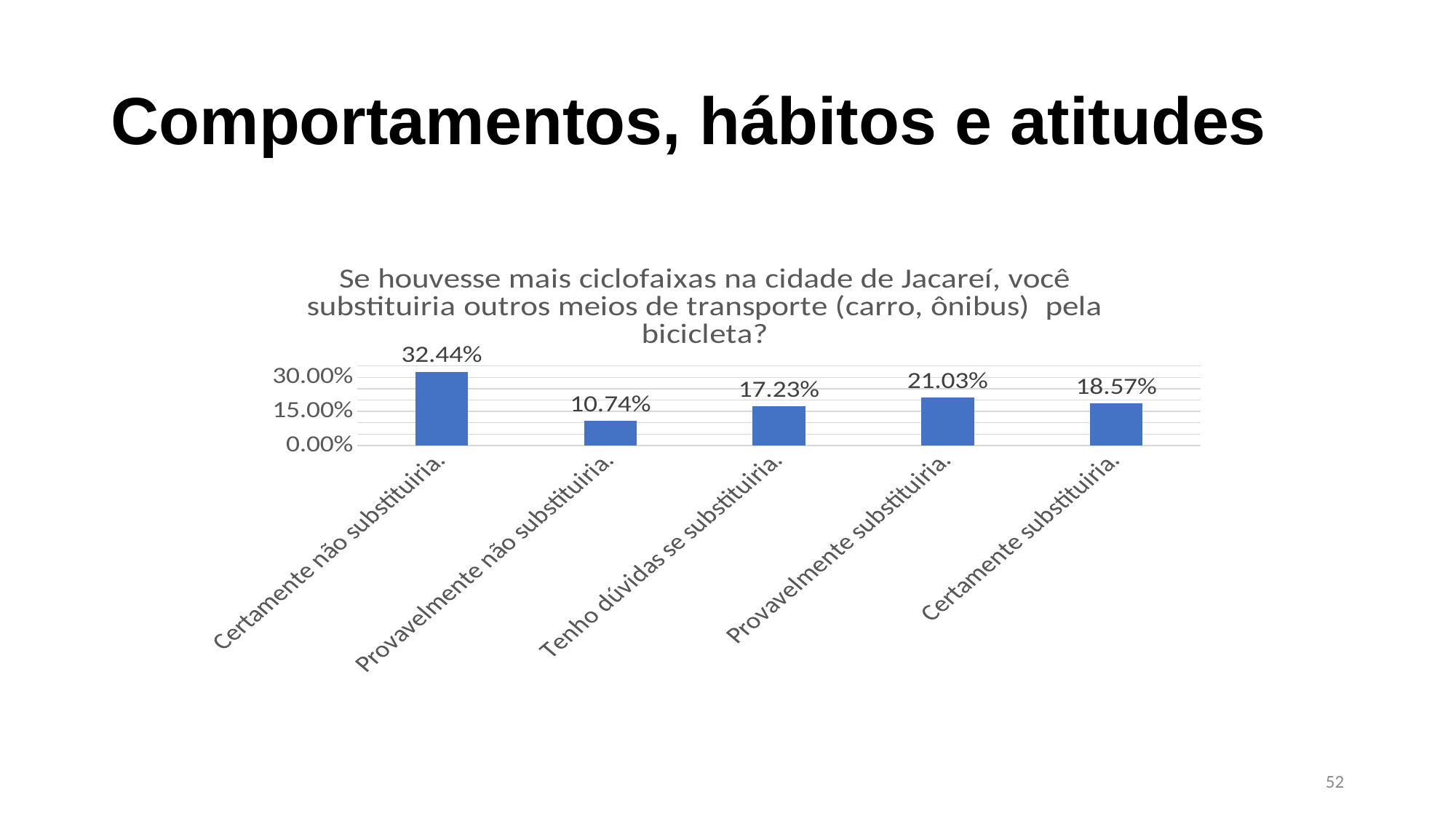
What is the value for "Tenho dúvidas se substituiria."? 17.23% What is the value for "Certamente substituiria."? 18.57% Which is larger, the value for "Provavelmente substituiria." or the value for "Certamente substituiria."? Provavelmente substituiria. How many categories are shown on the x axis? 5 What kind of chart is shown on the slide? Bar chart What is the value for "Provavelmente não substituiria."? 10.74% Which category has the highest value? Certamente não substituiria. What is the value for "Certamente não substituiria."? 32.44% What is the difference between the values for "Certamente não substituiria." and "Provavelmente não substituiria."? 21.70% What is the title of the chart? Se houvesse mais ciclofaixas na cidade de Jacareí, você substituiria outros meios de transporte (carro, ônibus) pela bicicleta? What is the value for "Provavelmente substituiria."? 21.03% Which category has the lowest value? Provavelmente não substituiria.